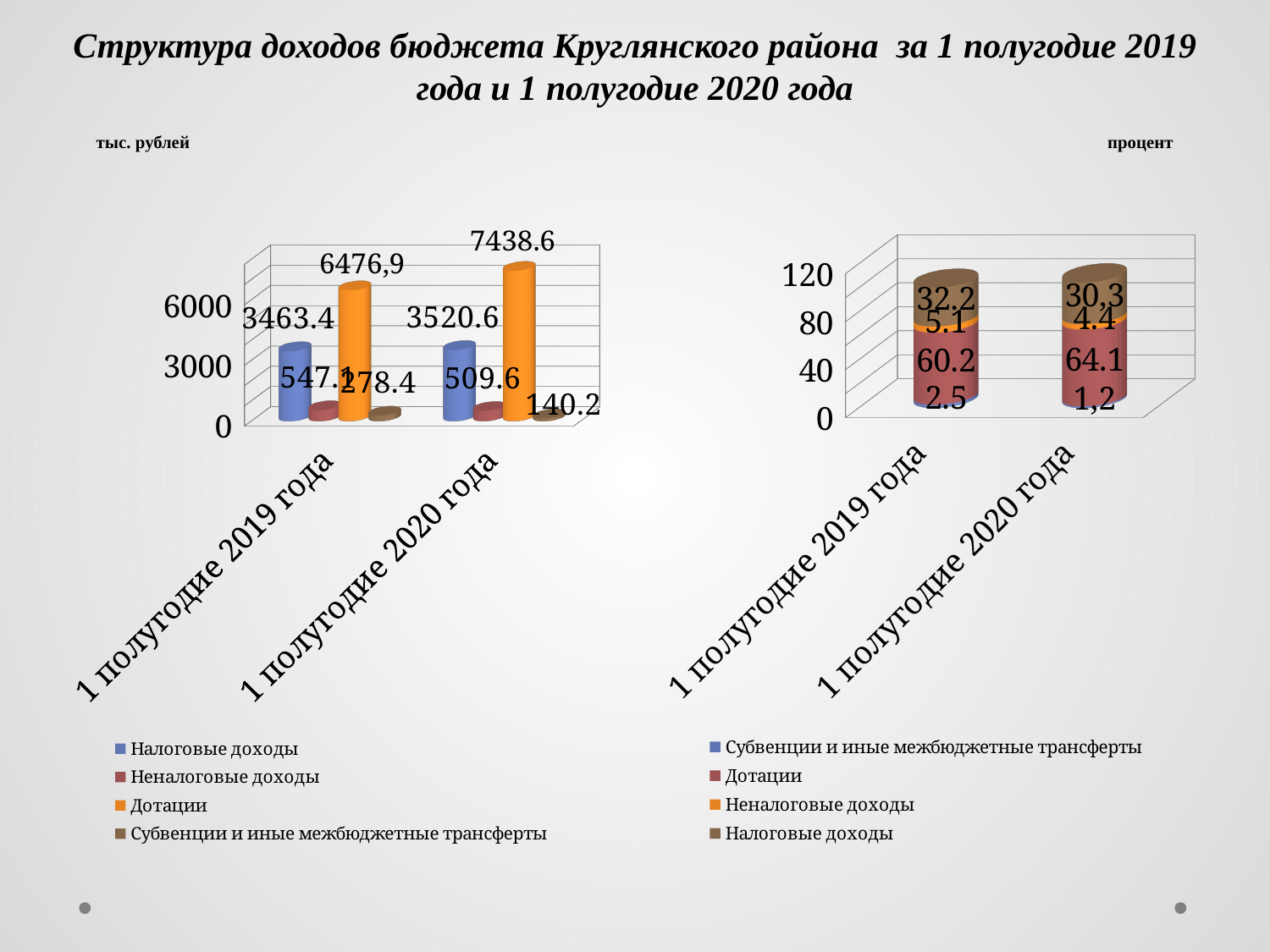
In the left chart (тыс. рублей), what is the value of Субвенции и иные межбюджетные трансферты for 1 полугодие 2020 года? 140.2 In the left chart (тыс. рублей), by how much did Налоговые доходы increase from 1 полугодие 2019 года to 1 полугодие 2020 года? 57.2 In the left chart (тыс. рублей), which series has the highest value for 1 полугодие 2020 года? Дотации How many series does the legend of the left chart (тыс. рублей) list? 4 What type of chart is the left chart (тыс. рублей)? Bar chart How many categories are shown on the x axis of the right chart (процент)? 2 In the left chart (тыс. рублей), what is the value of Налоговые доходы for 1 полугодие 2019 года? 3463.4 In the right chart (процент), is the value of Дотации larger for 1 полугодие 2019 года or 1 полугодие 2020 года? 1 полугодие 2020 года In the right chart (процент), what is the value of Дотации for 1 полугодие 2020 года? 64.1 In the left chart (тыс. рублей), what is the value of Дотации for 1 полугодие 2020 года? 7438.6 In the right chart (процент), what is the value of Налоговые доходы for 1 полугодие 2019 года? 32.2 In the left chart (тыс. рублей), what is the value of Дотации for 1 полугодие 2019 года? 6476,9